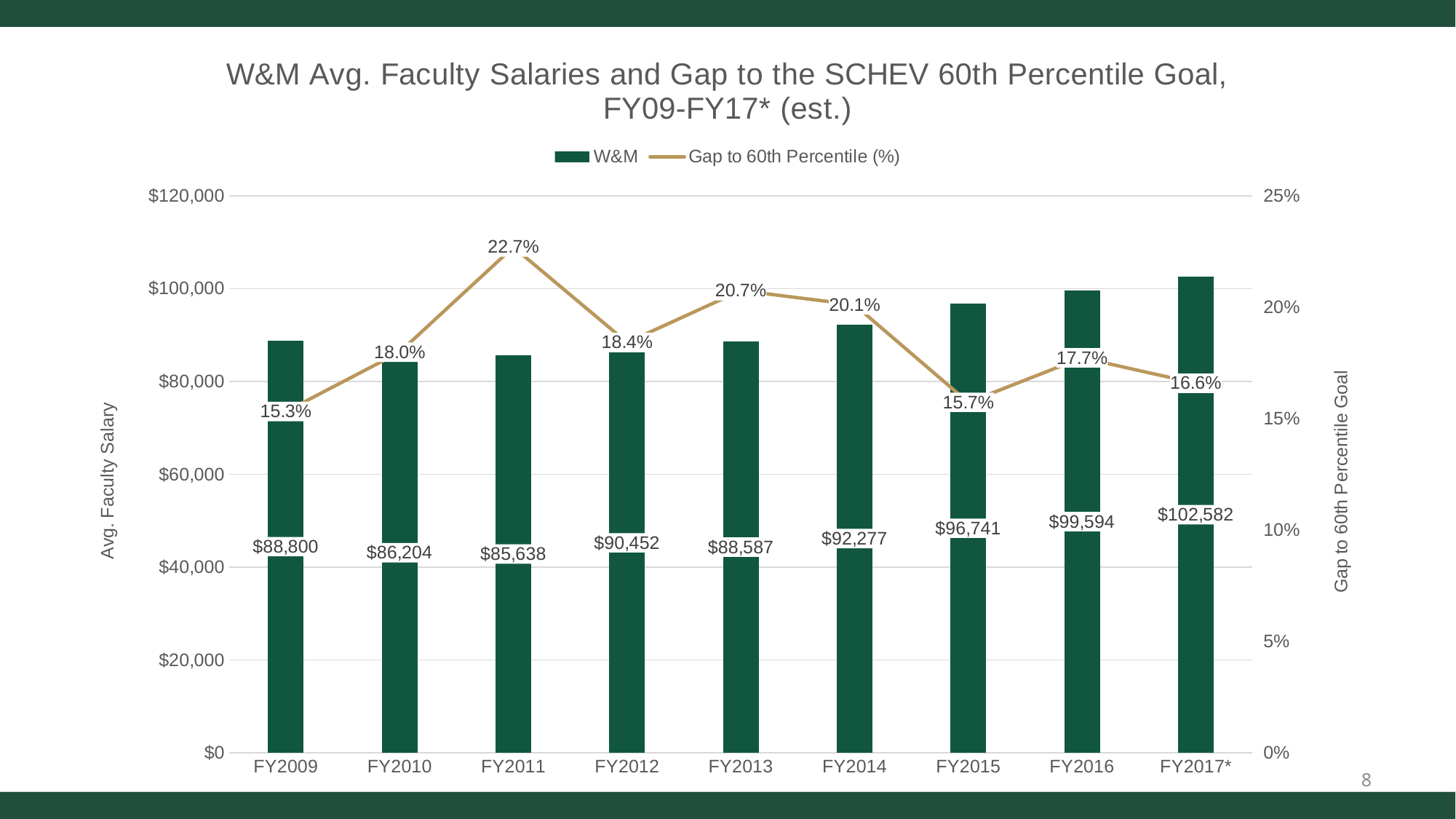
What kind of chart is used to show the W&M average faculty salary? Bar chart What is the difference between the W&M average faculty salary in FY2017* and in FY2009? $13,782 What is the Gap to 60th Percentile (%) for FY2011? 22.7% How many series does the legend list? 2 Which fiscal year has the highest W&M average faculty salary? FY2017* Is the Gap to 60th Percentile (%) for FY2015 greater or less than 20%? less What is the W&M average faculty salary for FY2014? $92,277 Which fiscal year has the lowest W&M average faculty salary? FY2011 Is the W&M average faculty salary higher in FY2012 or in FY2013? FY2012 What is the label of the right-hand vertical axis? Gap to 60th Percentile Goal Which fiscal year has the lowest Gap to 60th Percentile (%)? FY2009 How many fiscal years are shown on the x axis? 9